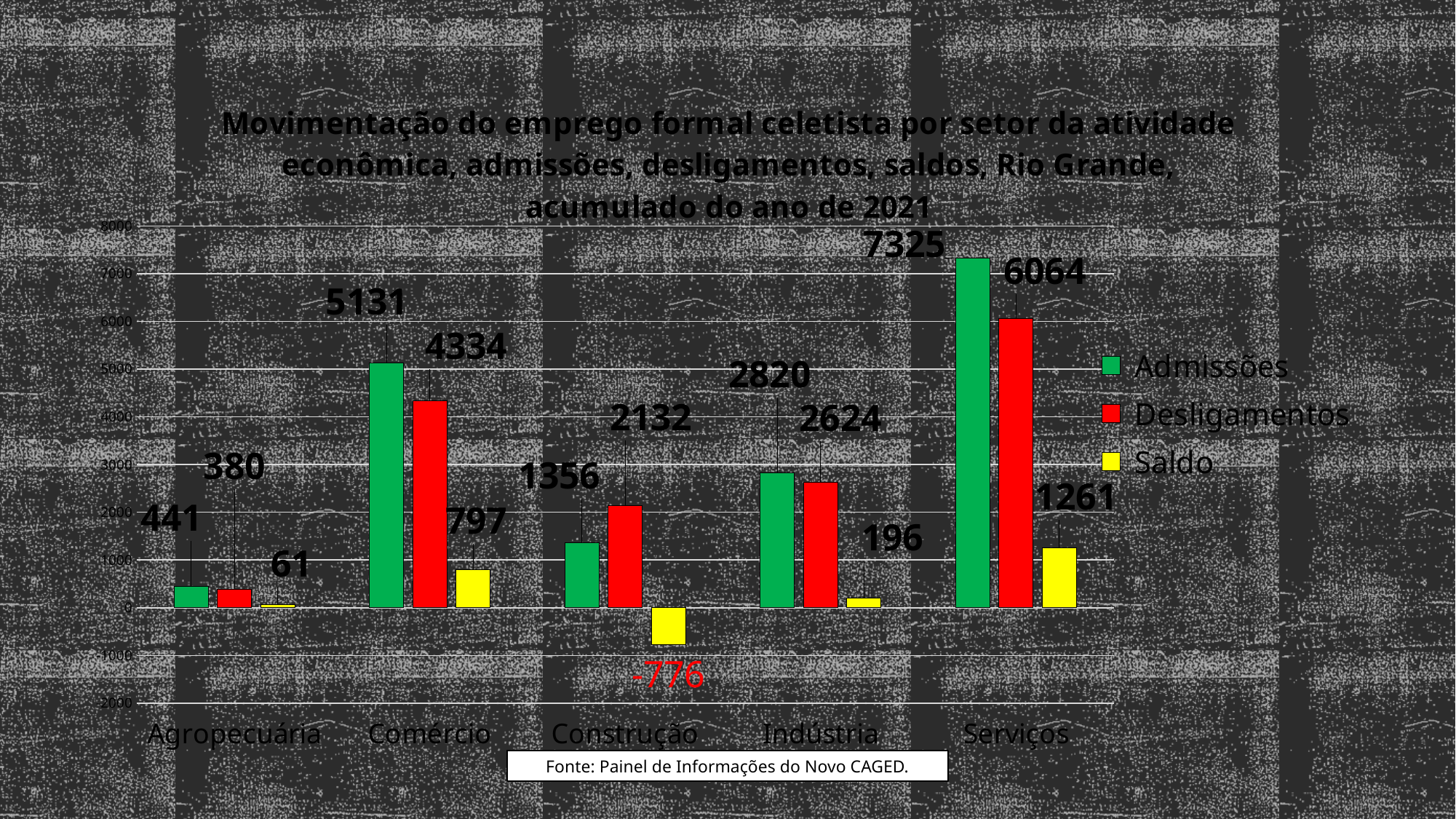
Which sector has the lowest Saldo value? Construção What is the Saldo value for Construção? -776 What is the value of Admissões for Serviços? 7325 What colour represents the Saldo series? Yellow Which sector has the highest Admissões value? Serviços Which is larger for Construção, Admissões or Desligamentos? Desligamentos What is the value of Desligamentos for Comércio? 4334 What kind of chart is shown on the slide? Bar chart How many series does the legend list? 3 How many sectors are shown on the x axis? 5 What is the difference between Admissões and Desligamentos for Indústria? 196 What is the Saldo value for Agropecuária? 61